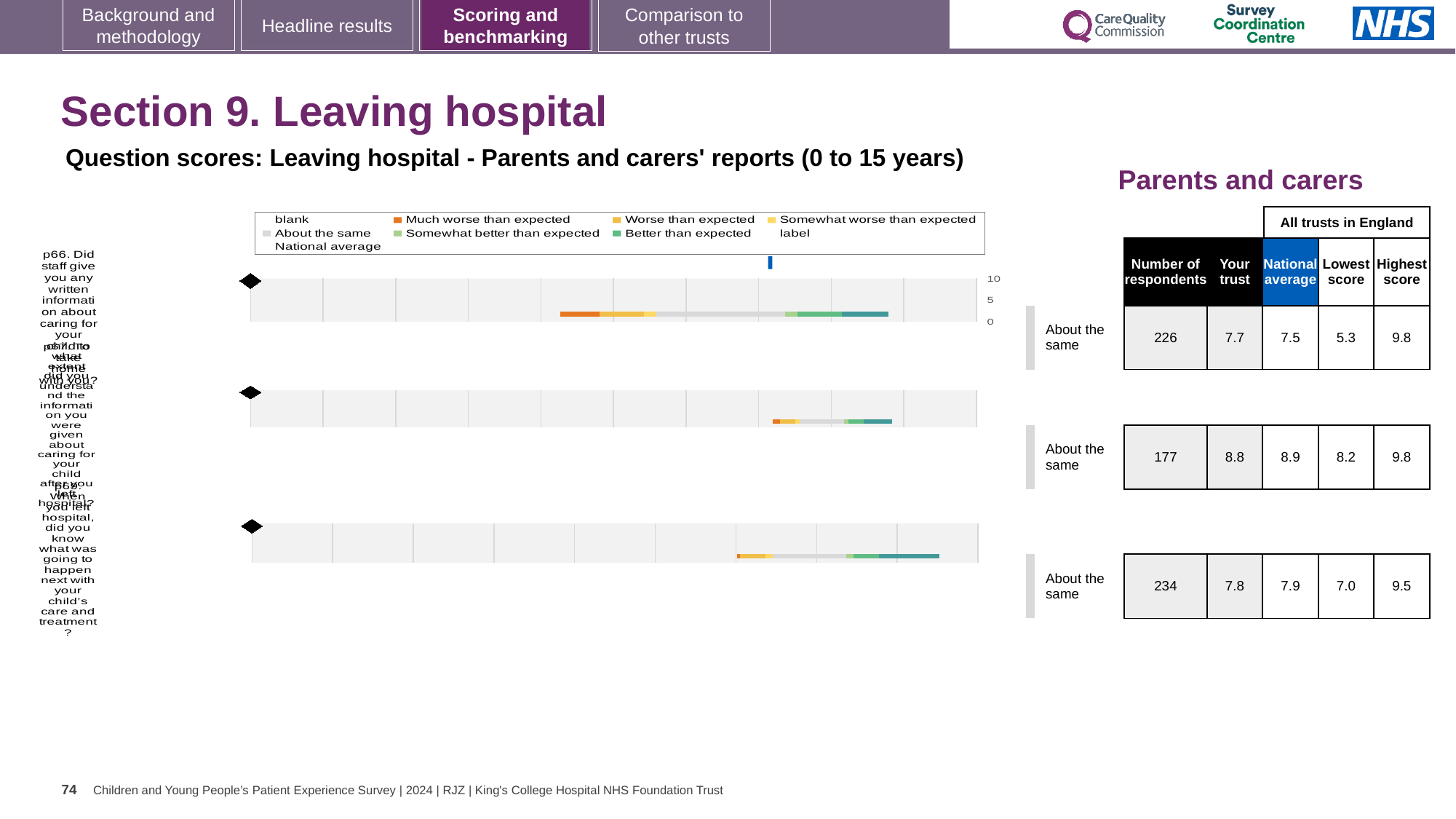
For the middle question row, which is larger: the 'Your trust' score or the national average? National average Which question row has the lowest 'Lowest score' value? the top row (5.3) What is the lowest score among all trusts in England for the top question row? 5.3 What is the national average for the middle question row in the table? 8.9 For the top question row, what is the difference between the 'Your trust' score and the national average? 0.2 In the chart legend, which colour represents 'Much worse than expected'? orange What is the highest score among all trusts in England for the bottom question row? 9.5 What kind of chart is used to show the question scores on this slide? bar chart Which question row has the largest number of respondents? the bottom row (234) What is the 'Your trust' score for the top question row in the table? 7.7 How many respondents are listed for the bottom question row? 234 How many question rows (bars) are plotted in the chart? 3